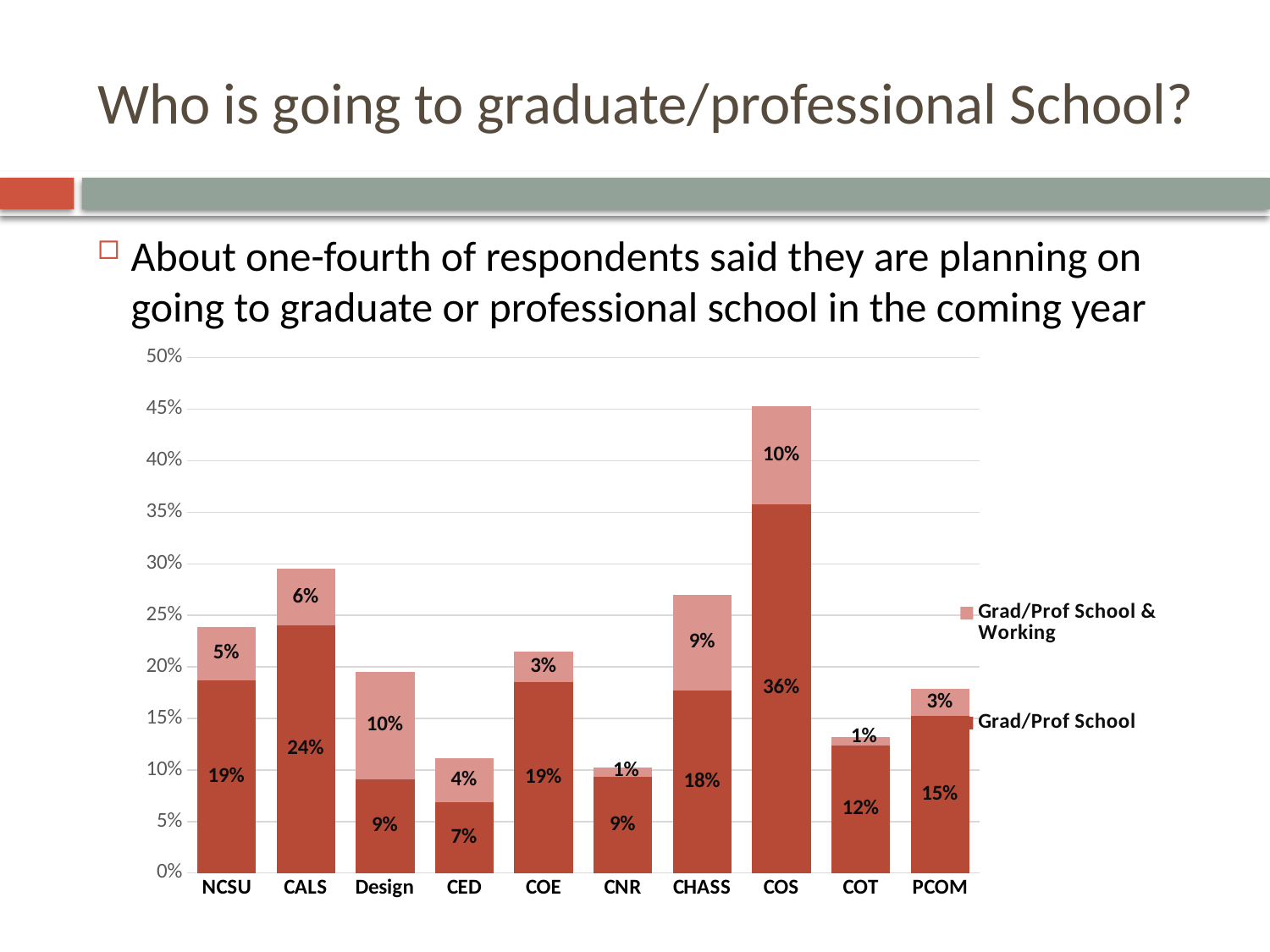
Is the total height of the COS stacked bar greater or less than 40%? greater What is the difference between the Grad/Prof School values for COS and CALS? 12% Which category has the highest Grad/Prof School value? COS What is the Grad/Prof School & Working value for Design? 10% Which has the larger Grad/Prof School value, CALS or NCSU? CALS Which category has the lowest Grad/Prof School value? CED What is the Grad/Prof School value for COS? 36% How many series does the legend list? 2 What is the Grad/Prof School & Working value for CHASS? 9% What kind of chart is shown on the slide? Stacked bar chart How many categories are shown on the x axis? 10 What is the Grad/Prof School value for CED? 7%